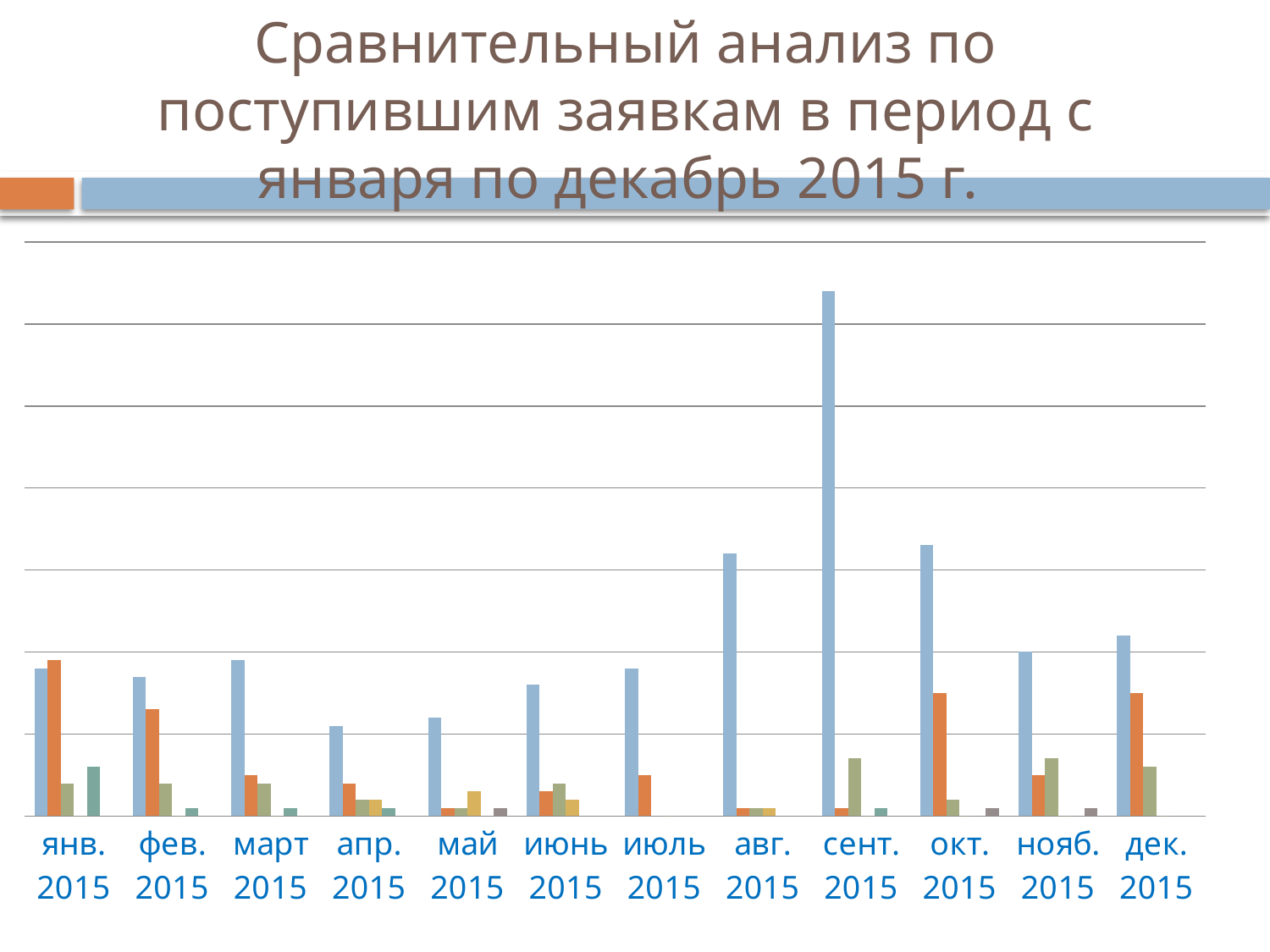
What kind of chart is shown on the slide? bar chart Which month has the larger blue bar, март 2015 or апр. 2015? март 2015 What colour is the tallest bar in the chart? blue How many months (categories) are shown along the x axis of the chart? 12 What is the title of the slide containing the chart? Сравнительный анализ по поступившим заявкам в период с января по декабрь 2015 г. Which month has the larger orange bar, янв. 2015 or апр. 2015? янв. 2015 Which month has the larger orange bar, фев. 2015 or март 2015? фев. 2015 In which month is the blue bar the tallest? сент. 2015